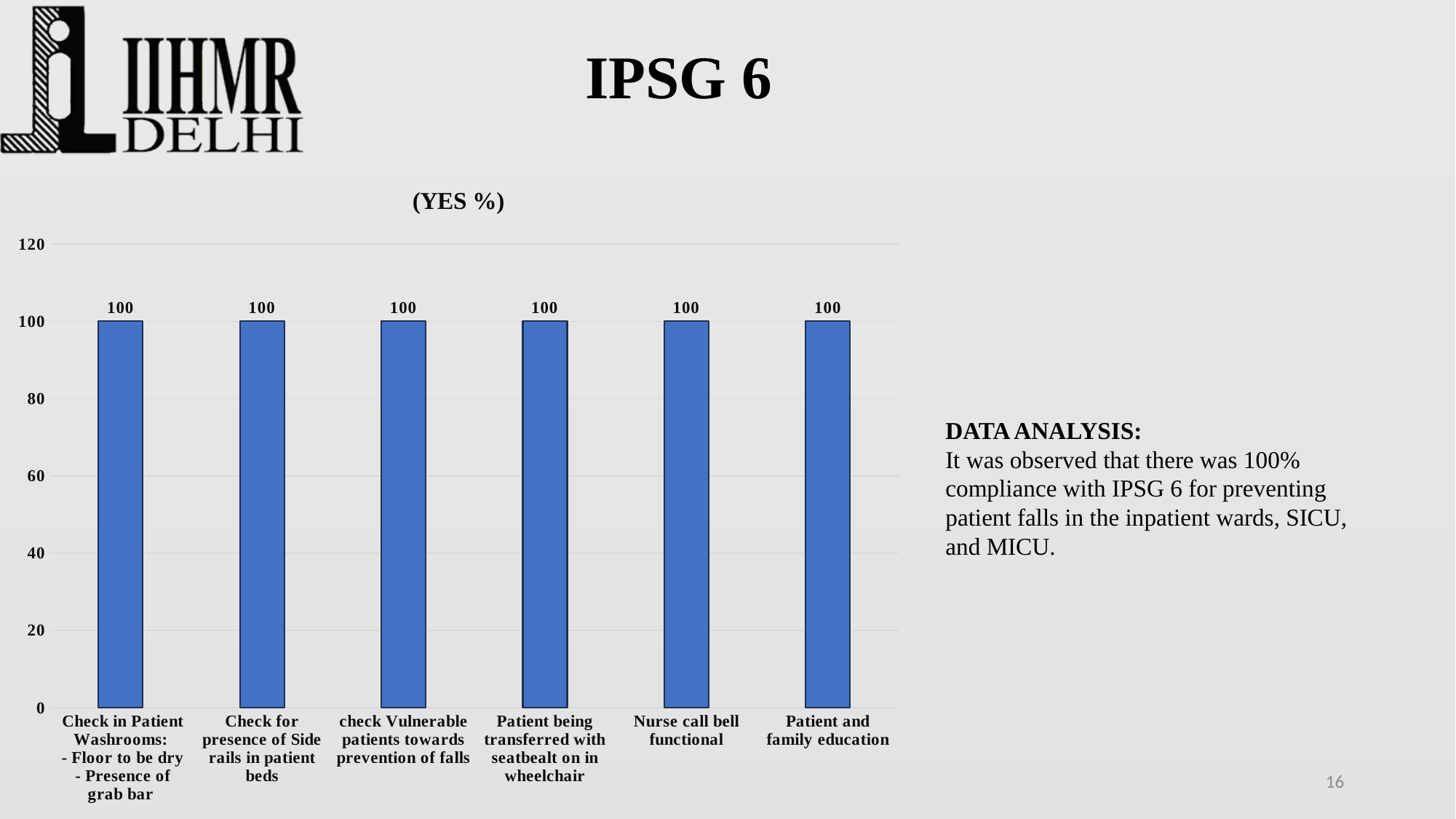
What is the value for "Check for presence of Side rails in patient beds"? 100 What kind of chart is shown on the slide? Bar chart How many categories are shown on the chart? 6 What is the title of the chart? (YES %) What is the value for "Patient and family education"? 100 Do the values rise, fall, or stay the same across the categories from left to right? Stay the same Is the value for "Nurse call bell functional" greater or less than 120? less What is the value for "Patient being transferred with seatbealt on in wheelchair"? 100 Is the value for "check Vulnerable patients towards prevention of falls" greater or less than 80? greater What is the difference between the values for "Nurse call bell functional" and "Patient and family education"? 0 What is the highest value shown on the vertical axis? 120 What is the value for "Nurse call bell functional"? 100